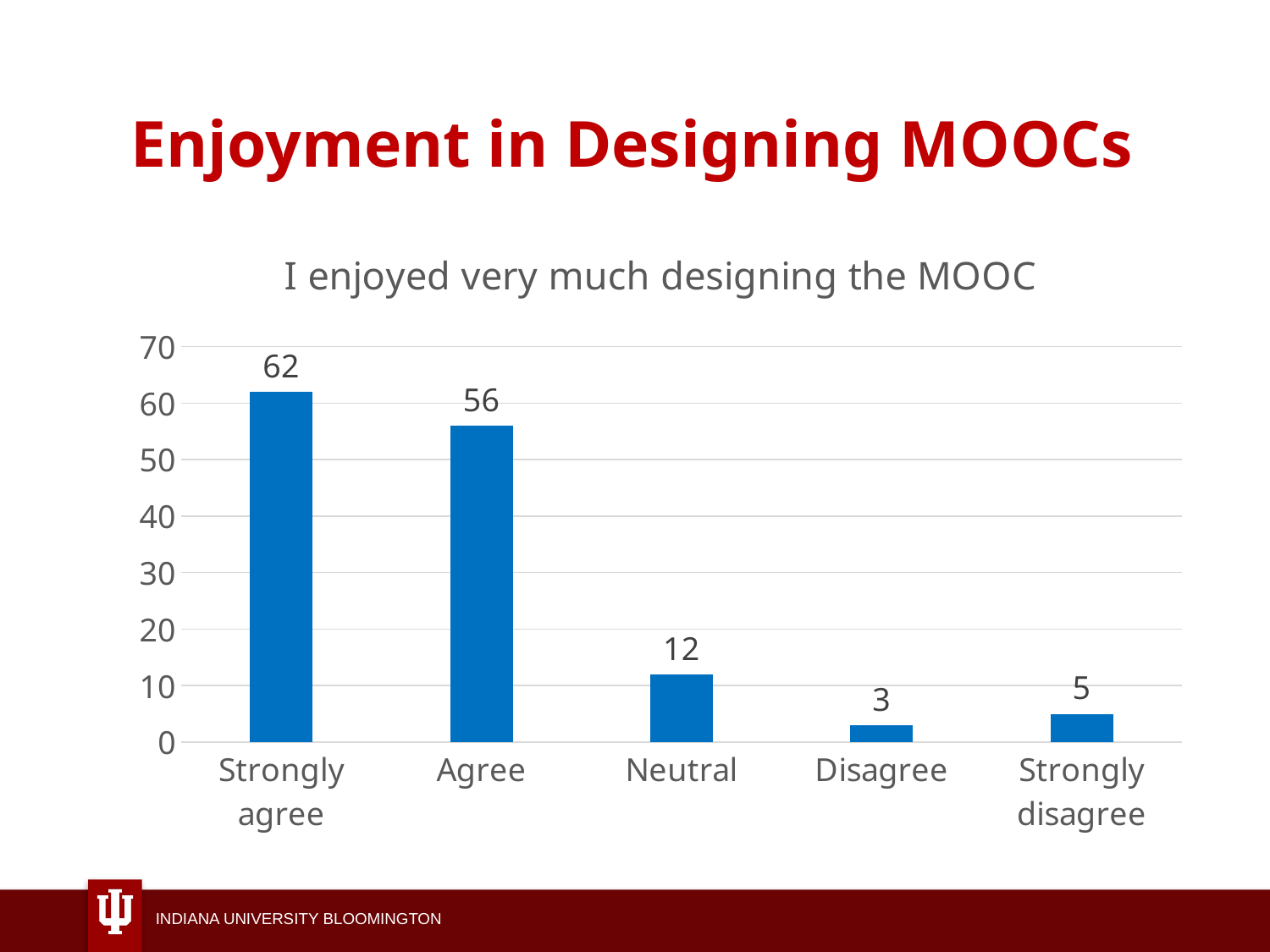
What is the value for Strongly agree? 62 What kind of chart is shown on the slide? bar chart What is the value for Neutral? 12 How many categories are shown on the x axis? 5 What is the value for Disagree? 3 Which category has the highest value? Strongly agree Is the value for Agree greater or less than 50? greater Which category has the lowest value? Disagree What is the difference between the values for Strongly agree and Agree? 6 Which is larger, the value for Agree or the value for Neutral? Agree What is the title of the chart? I enjoyed very much designing the MOOC What is the difference between the values for Neutral and Strongly disagree? 7